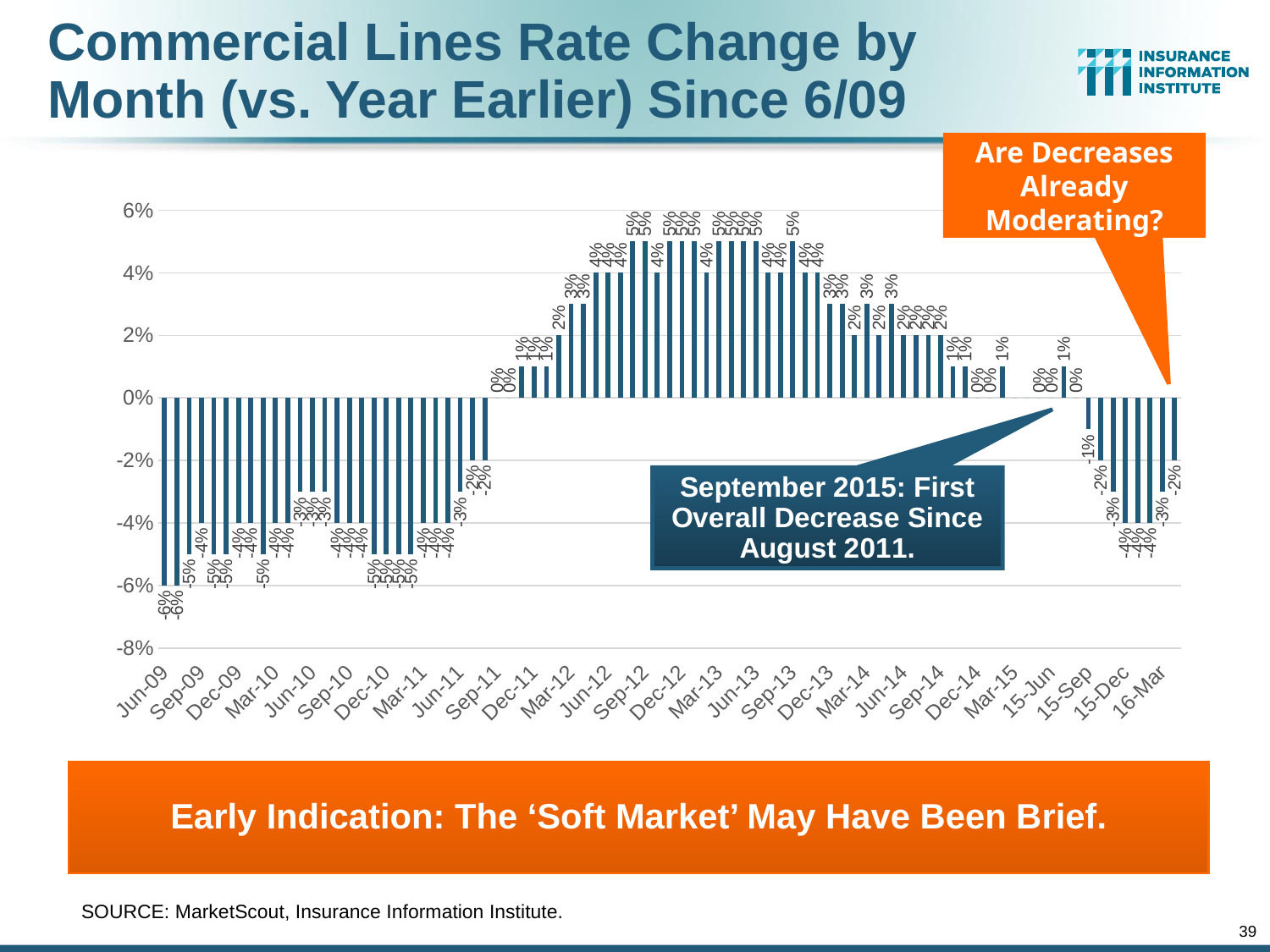
Do the values generally rise or fall from Sep-12 to 16-Mar? fall What is the rate change shown for Jun-09? -6% According to the callout on the chart, which month was the first overall decrease since August 2011? September 2015 What kind of chart is shown on the slide? bar chart Which is larger, the value for Jun-09 or the value for 16-Mar? 16-Mar Do the values generally rise or fall from Jun-09 to Sep-12? rise Is the value for Dec-10 greater or less than -2%? less What is the lowest value shown on the chart? -6% Is the value for Jun-12 greater or less than 2%? greater What is the highest value shown on the chart? 5%